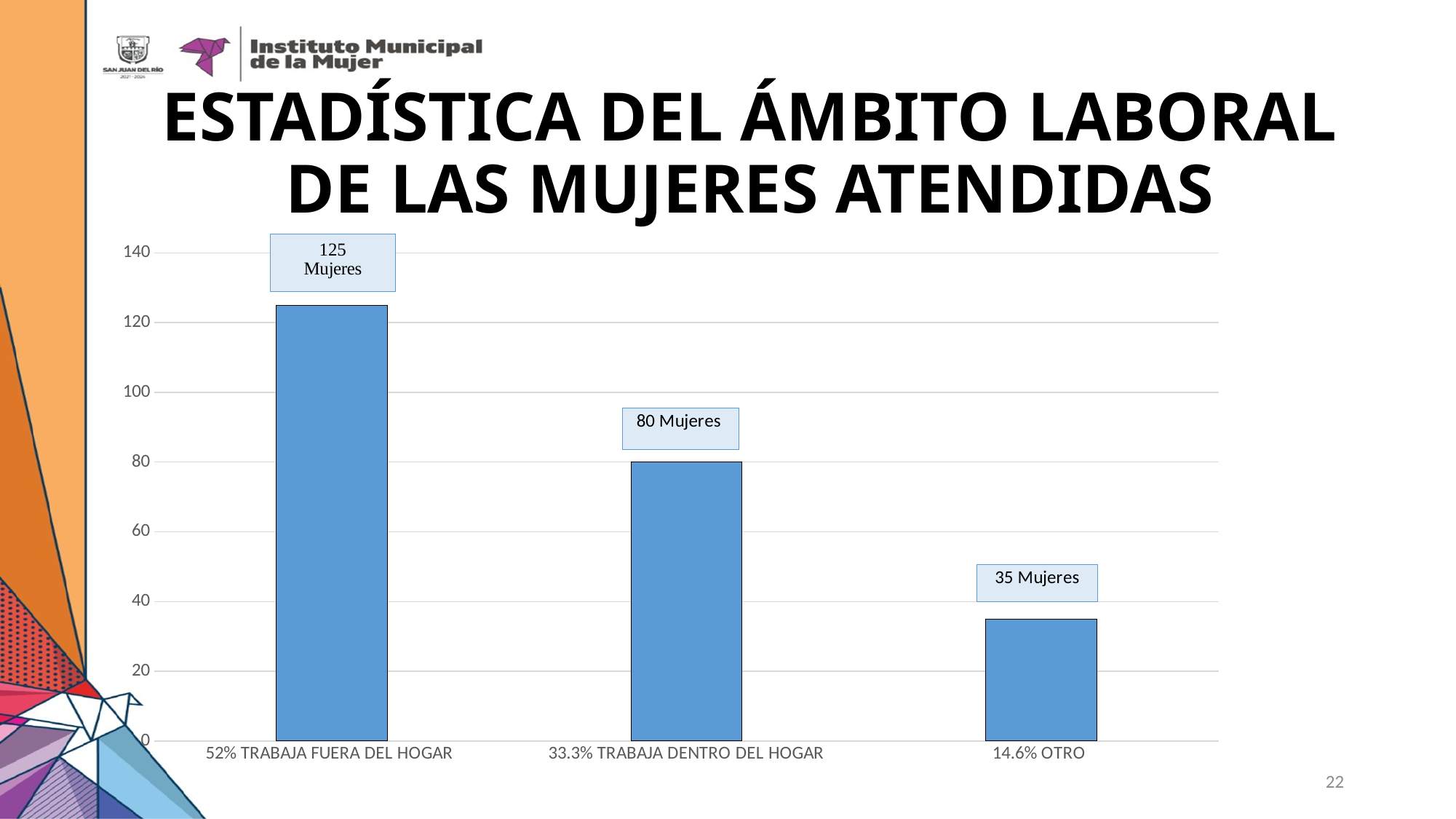
What is the difference in the number of women between 'TRABAJA DENTRO DEL HOGAR' and 'OTRO'? 45 Which has more women, 'TRABAJA DENTRO DEL HOGAR' or 'OTRO'? TRABAJA DENTRO DEL HOGAR How many categories are shown in the chart? 3 Do the values rise or fall from left to right across the categories? Fall How many women are shown for the category '52% TRABAJA FUERA DEL HOGAR'? 125 Mujeres What type of chart is shown on the slide? Bar chart What is the difference in the number of women between 'TRABAJA FUERA DEL HOGAR' and 'TRABAJA DENTRO DEL HOGAR'? 45 How many women are shown for the category '33.3% TRABAJA DENTRO DEL HOGAR'? 80 Mujeres Which category has the highest number of women? 52% TRABAJA FUERA DEL HOGAR How many women are shown for the category '14.6% OTRO'? 35 Mujeres Which category has the lowest number of women? 14.6% OTRO Is the value for 'OTRO' greater or less than 40? less